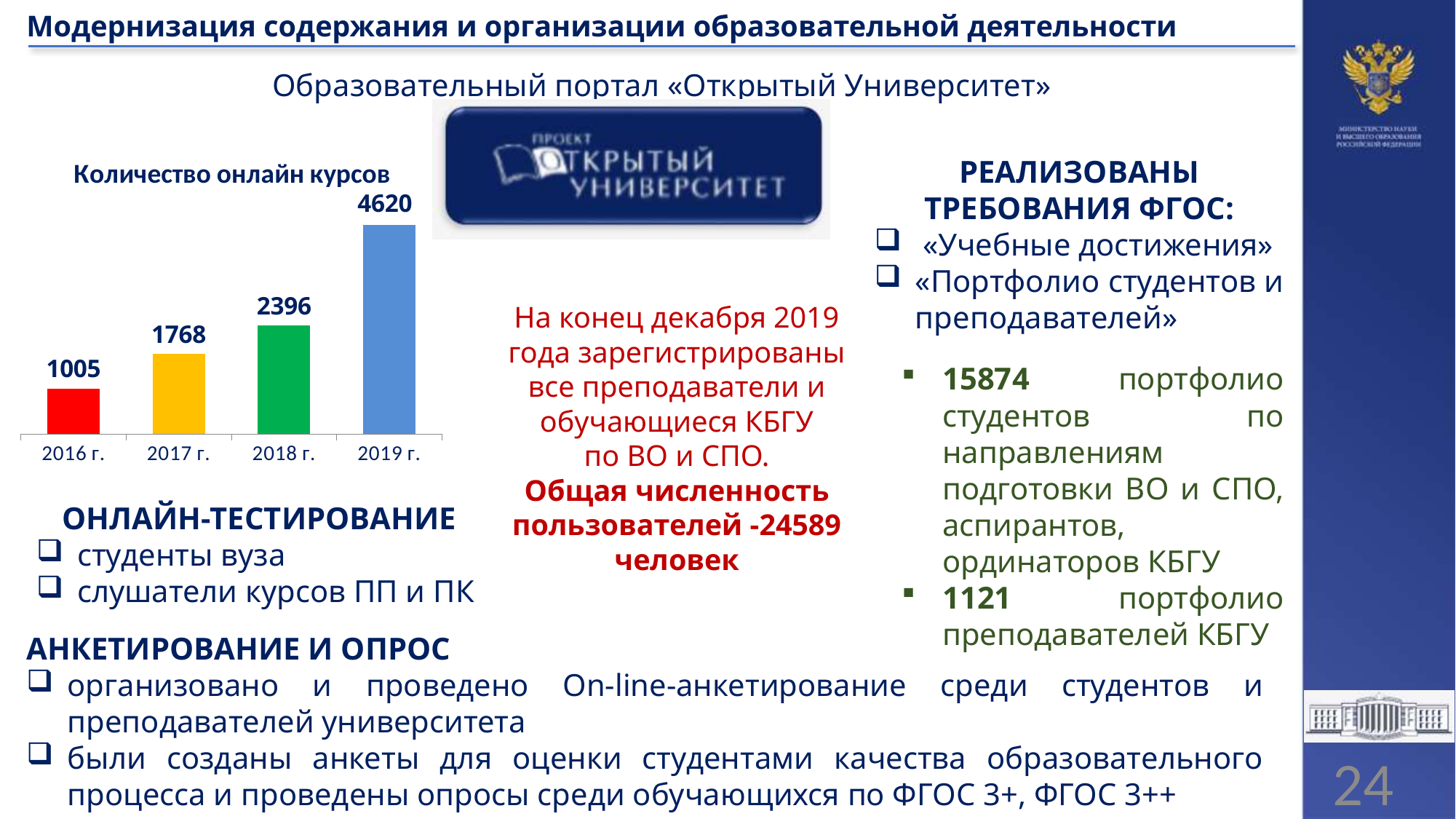
What is the number of online courses shown for 2019 г.? 4620 What is the number of online courses shown for 2018 г.? 2396 Which year has more online courses, 2017 г. or 2018 г.? 2018 г. Which year has the highest number of online courses? 2019 г. How many years are shown in the chart? 4 Does the number of online courses rise or fall from 2016 г. to 2019 г.? rise What is the number of online courses shown for 2016 г.? 1005 What is the difference in the number of online courses between 2017 г. and 2016 г.? 763 What is the number of online courses shown for 2017 г.? 1768 What kind of chart is used to show the number of online courses? bar chart What is the difference in the number of online courses between 2019 г. and 2018 г.? 2224 Which year has the lowest number of online courses? 2016 г.